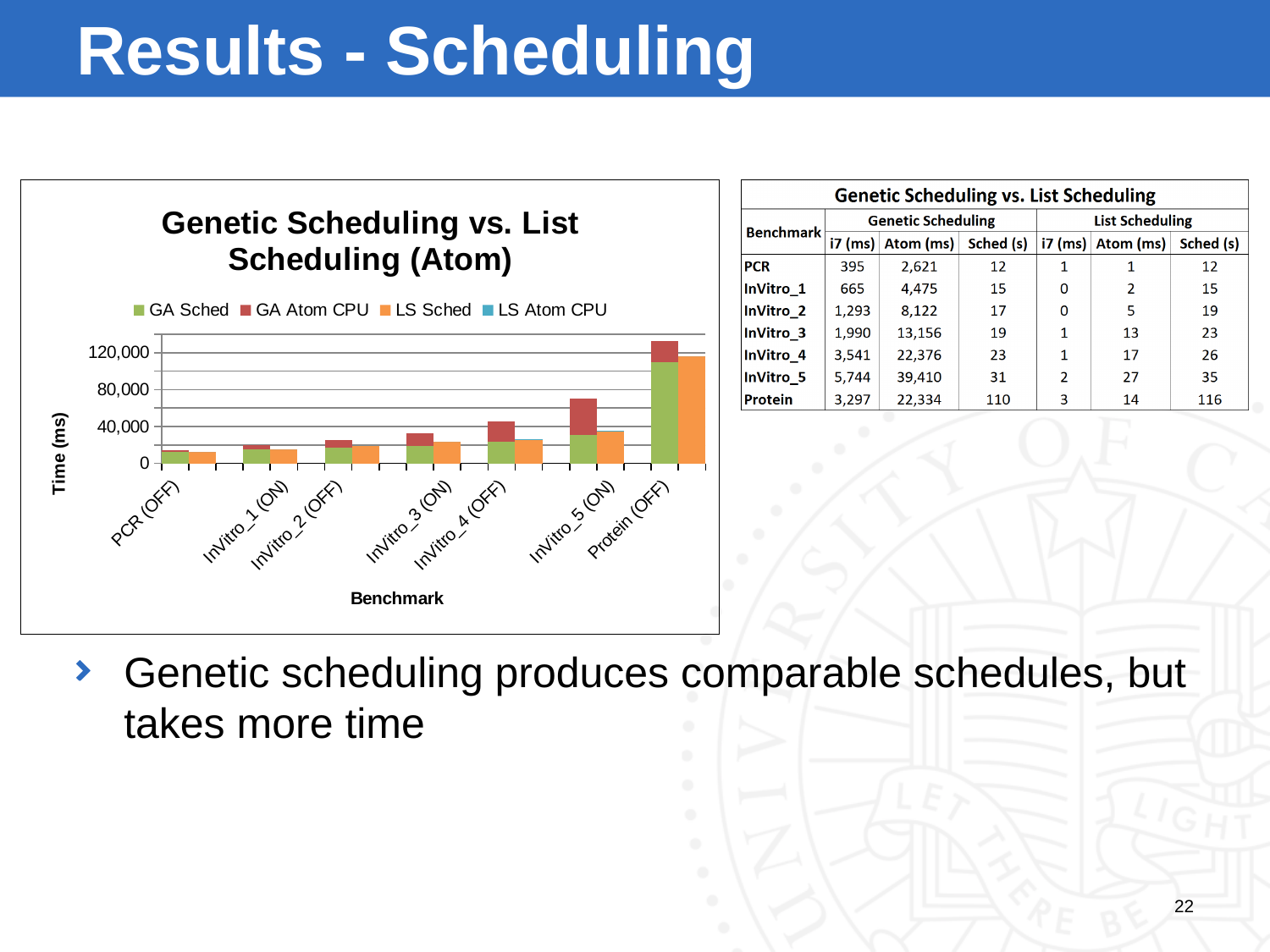
Do the bar heights generally rise or fall from PCR (OFF) to Protein (OFF) along the x axis? Rise What kind of chart is shown on the slide? Stacked bar chart Is the GA stacked bar for InVitro_4 (OFF) greater or less than 40,000? greater How many benchmark categories are shown on the x axis of the chart? 7 How many series does the chart legend list? 4 What is the title of the chart? Genetic Scheduling vs. List Scheduling (Atom) Is the GA stacked bar for Protein (OFF) greater or less than 120,000? greater Which benchmark has the tallest bars in the chart? Protein (OFF) What is the label of the y axis of the chart? Time (ms) Which has a taller GA stacked bar, InVitro_5 (ON) or Protein (OFF)? Protein (OFF) Is the GA stacked bar for InVitro_5 (ON) greater or less than 80,000? less